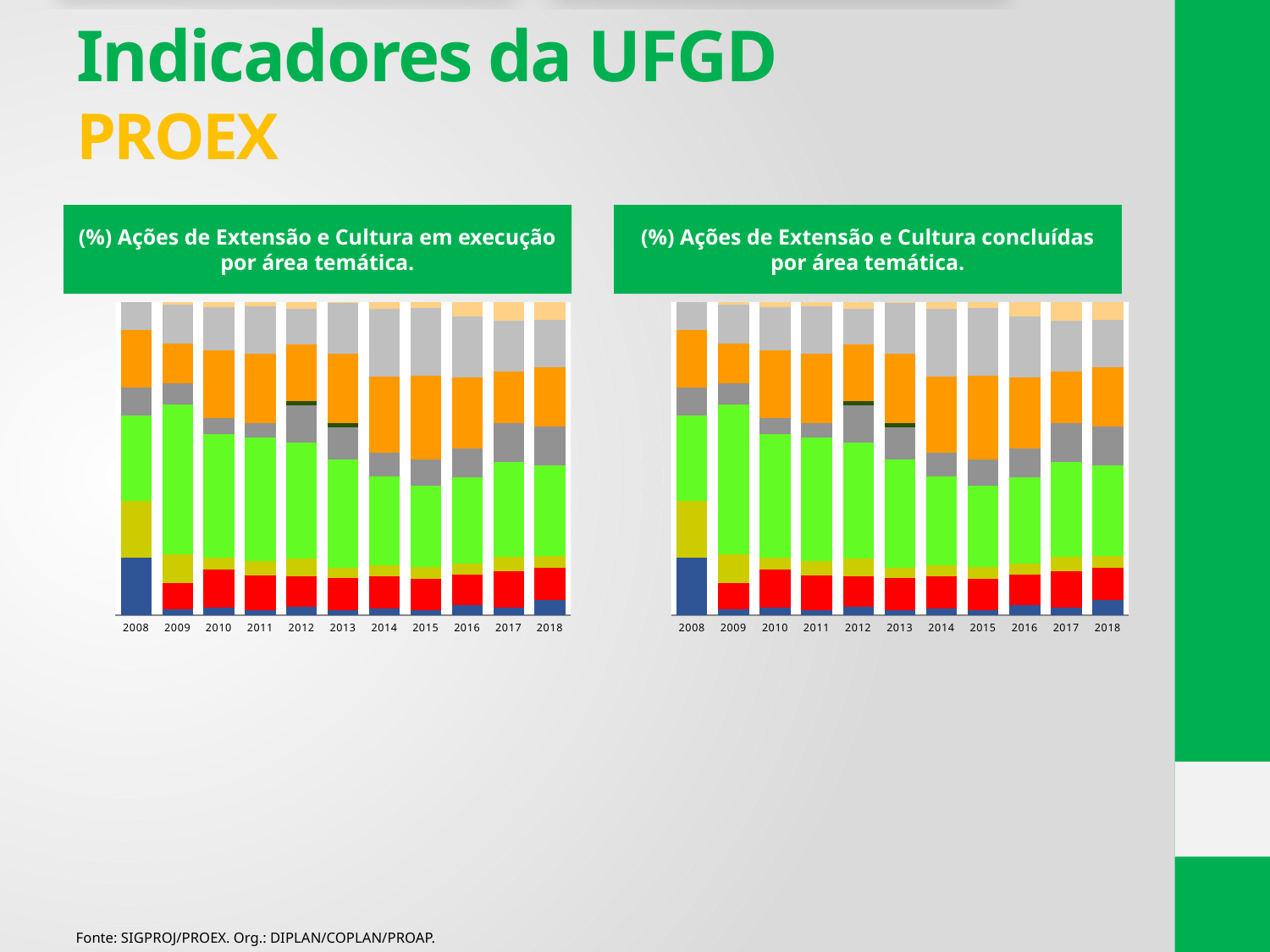
In the left chart, does the bright green segment rise or fall from 2009 to 2015? Fall In the right chart, is the dark blue bottom segment larger in 2008 or in 2010? 2008 In the right chart, does the bright green segment rise or fall from 2009 to 2015? Fall In the left chart, is the dark blue bottom segment larger in 2008 or in 2009? 2008 What kind of chart is the right chart, '(%) Ações de Extensão e Cultura concluídas por área temática'? Stacked bar chart In the left chart, is the orange segment larger in 2008 or in 2014? 2014 What is the title of the right chart? (%) Ações de Extensão e Cultura concluídas por área temática. In the right chart, how many bars are plotted? 11 In the left chart, what is the last year shown on the x axis? 2018 In the left chart, how many years are shown on the x axis? 11 What kind of chart is the left chart, '(%) Ações de Extensão e Cultura em execução por área temática'? Stacked bar chart